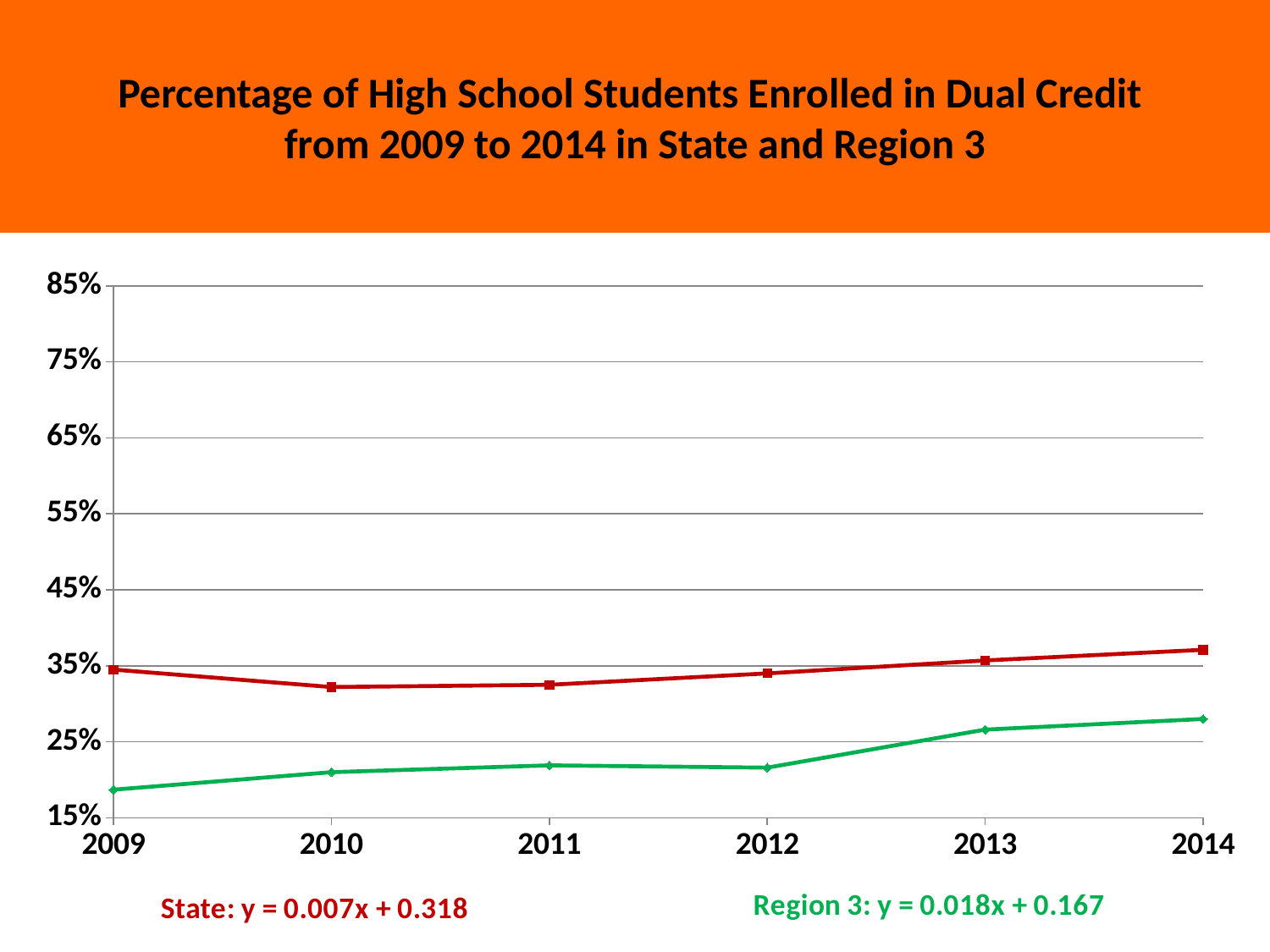
In which year does Region 3 have its lowest value? 2009 What kind of chart is shown on the slide? line chart In which year does Region 3 reach its highest value? 2014 Is the Region 3 value for 2009 greater or less than 25%? less What trend equation is shown for the State series? y = 0.007x + 0.318 How many series does the chart show? 2 Is the State value for 2010 greater or less than 35%? less Is the State value for 2014 greater or less than 35%? greater Does the Region 3 line generally rise or fall from 2009 to 2014? rise In 2009, which series has the higher value, State or Region 3? State How many years are plotted along the x axis? 6